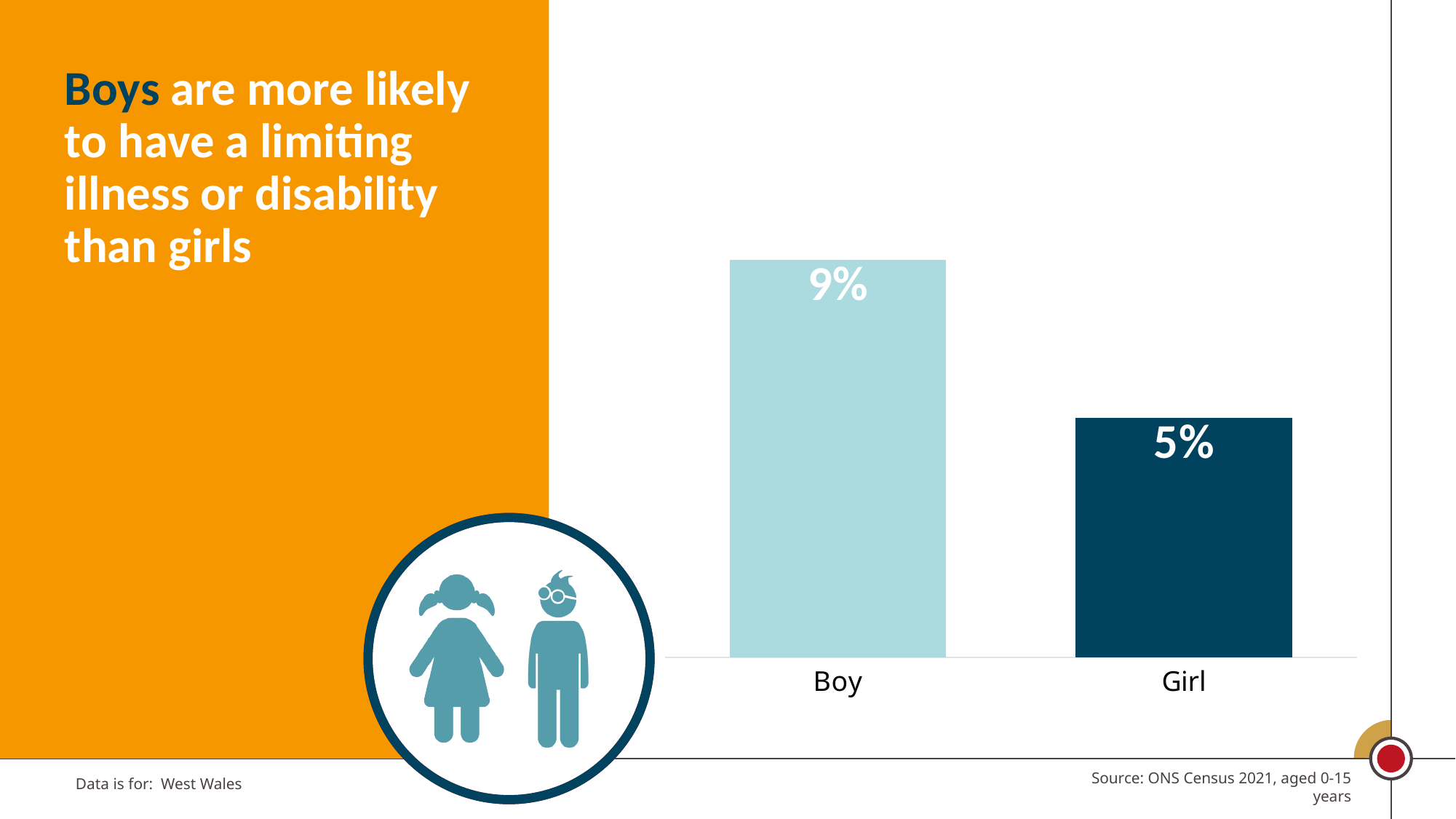
What kind of chart is shown on the slide? Bar chart Do the values rise or fall from Boy to Girl? Fall Which category has the highest value? Boy What colour is the bar for Girl? Dark blue What is the value for Boy? 9% What is the difference between the values for Boy and Girl? 4% Which category has the lowest value? Girl Which is larger, the value for Boy or the value for Girl? Boy How many categories are shown in the chart? 2 What is the value for Girl? 5% What area does the data on the slide cover? West Wales